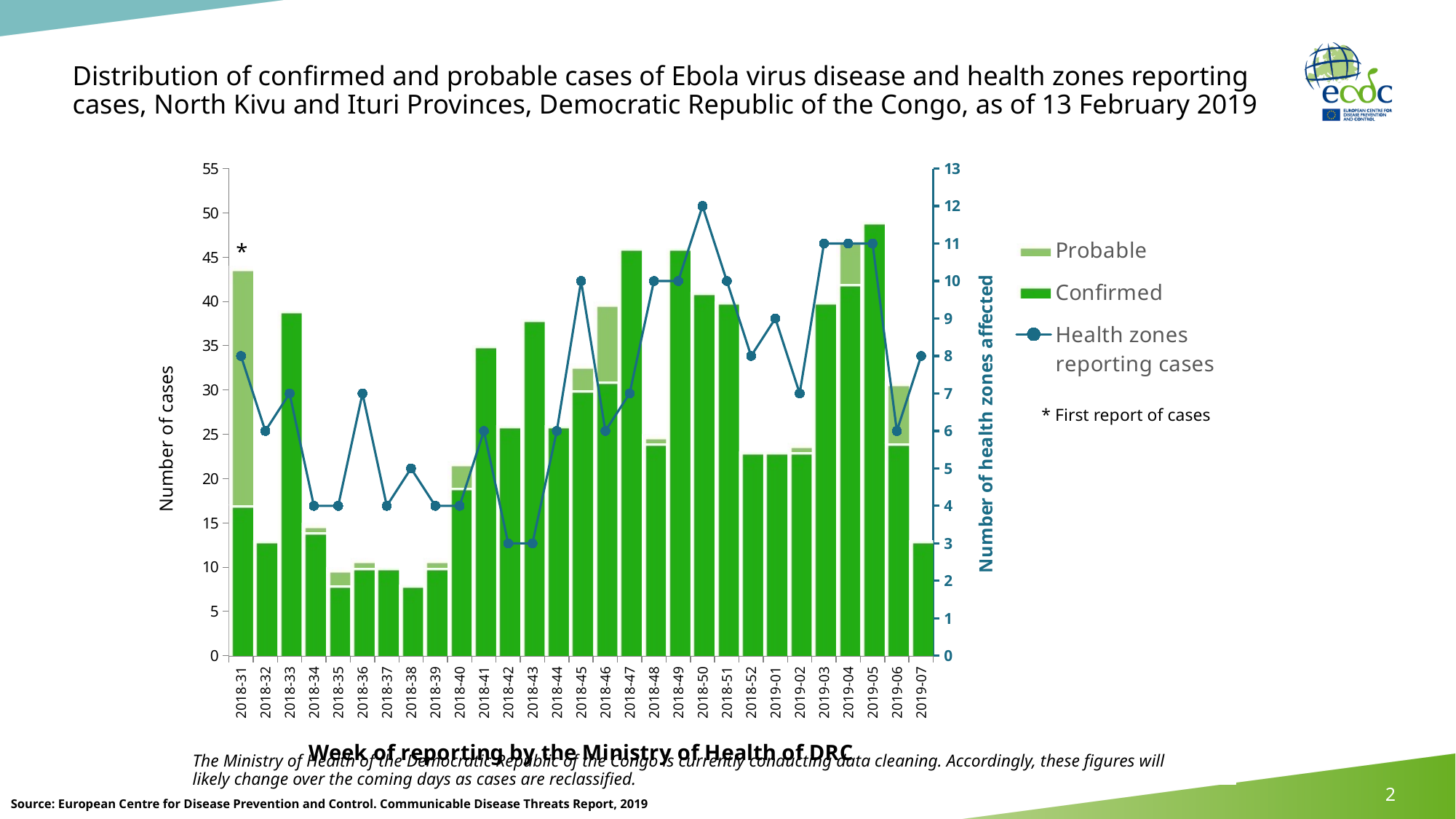
In which week did the number of health zones reporting cases reach its highest value? 2018-50 How many health zones were reporting cases in week 2018-50? 12 How many series does the legend list? 3 Is the total number of cases for week 2018-33 greater or less than 35? greater What is the difference in the number of health zones reporting cases between week 2018-50 and week 2018-42? 9 What does the asterisk above the first bar indicate, according to the slide? First report of cases Which week has the shortest bar for total cases? 2018-38 How many weeks are shown on the x axis? 29 Which week has the tallest bar for total cases (confirmed plus probable)? 2019-05 Which week had more health zones reporting cases, 2018-45 or 2018-46? 2018-45 How many health zones were reporting cases in week 2019-03? 11 How many health zones were reporting cases in week 2018-31? 8